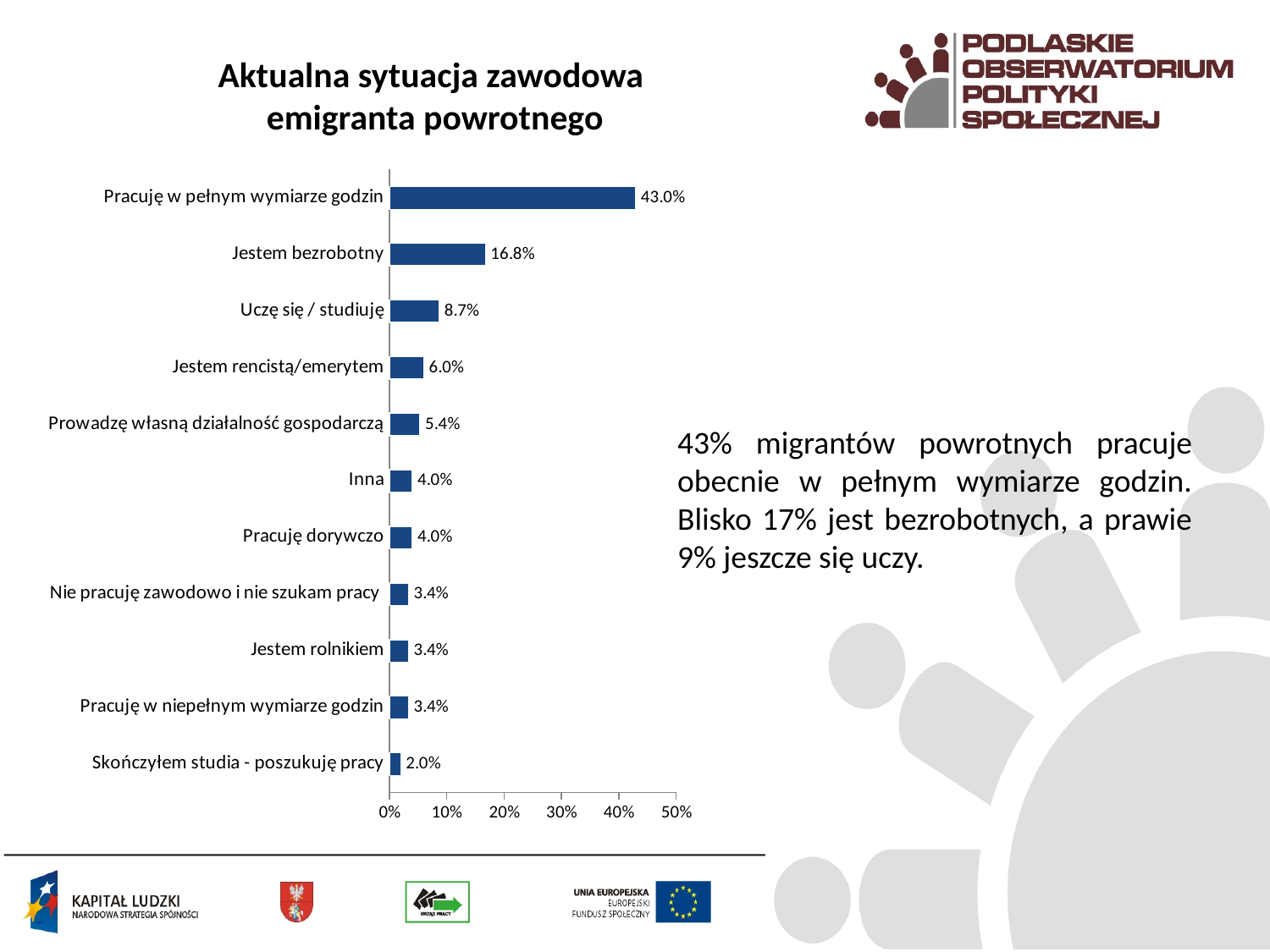
What is the difference between the values for "Pracuję w pełnym wymiarze godzin" and "Jestem bezrobotny"? 26.2 percentage points How many categories are shown in the chart? 11 What is the value for "Prowadzę własną działalność gospodarczą"? 5.4% What kind of chart is shown on the slide? Bar chart What is the value for "Jestem bezrobotny"? 16.8% Which category has the highest value? Pracuję w pełnym wymiarze godzin What is the value for "Uczę się / studiuję"? 8.7% Which is larger, the value for "Jestem rencistą/emerytem" or the value for "Uczę się / studiuję"? Uczę się / studiuję Which category has the lowest value? Skończyłem studia - poszukuję pracy What is the value for "Pracuję w pełnym wymiarze godzin"? 43.0% What is the title of the chart? Aktualna sytuacja zawodowa emigranta powrotnego Is the value for "Jestem bezrobotny" greater or less than 20%? less